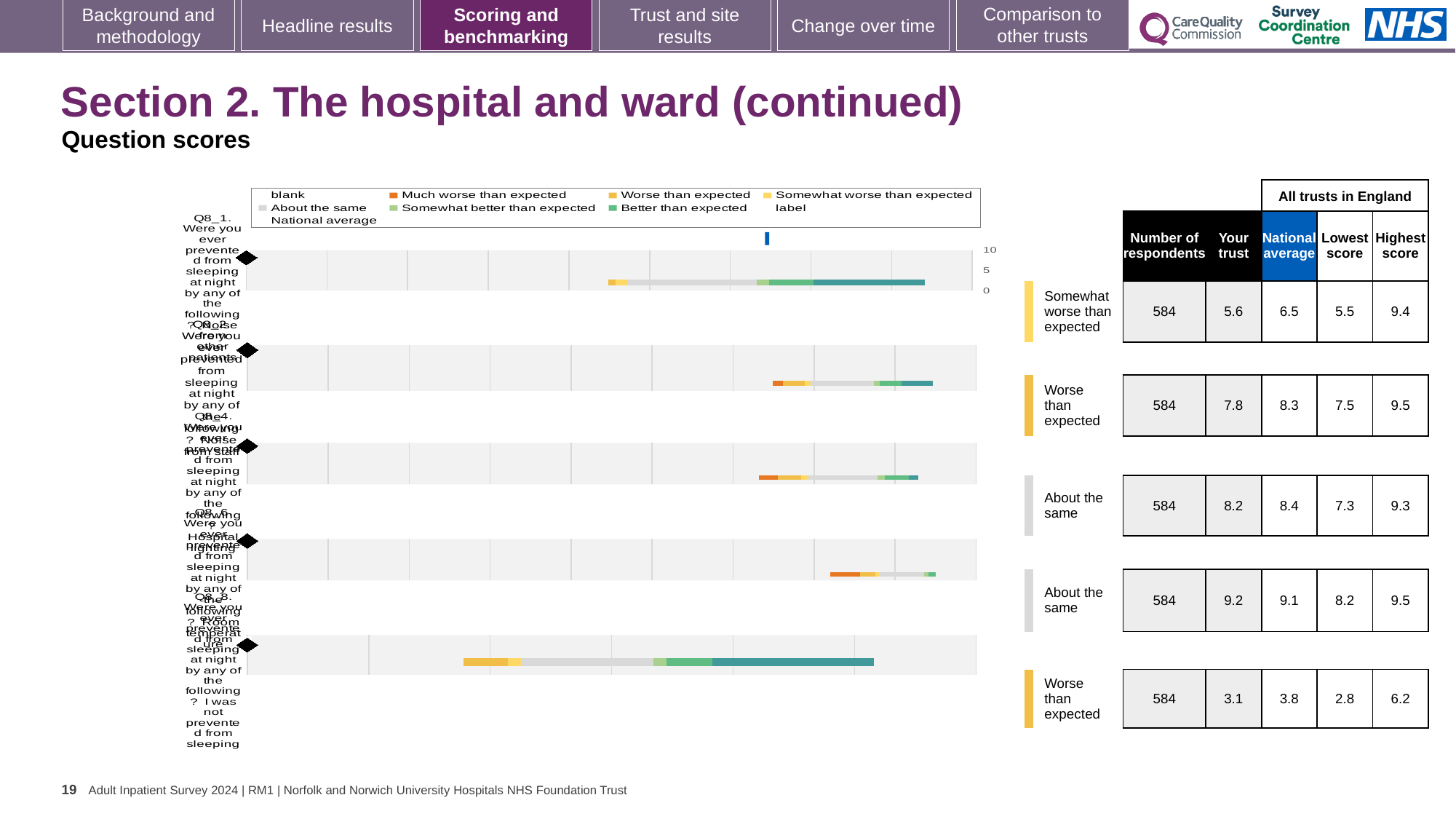
What kind of chart is shown on the left of the slide? bar chart In the table, what is the national average for the second row (Worse than expected)? 8.3 In the table, what is the highest score among all trusts in England for the last row (Worse than expected)? 6.2 How many question rows (bars) does the chart on the left show? 5 What colour represents 'Much worse than expected' in the chart legend? orange Which table row has the lowest 'Your trust' score? the last row (Worse than expected), 3.1 How many entries does the chart legend list? 9 In the first table row, what is the difference between the highest score (9.4) and the lowest score (5.5)? 3.9 In the table, what is the 'Your trust' score for the first row (Somewhat worse than expected)? 5.6 Which table row has the highest 'Your trust' score? the fourth row (About the same), 9.2 In the table, what is the number of respondents for the first row (Somewhat worse than expected)? 584 In the fourth table row, which is larger: the 'Your trust' score or the national average? Your trust (9.2)